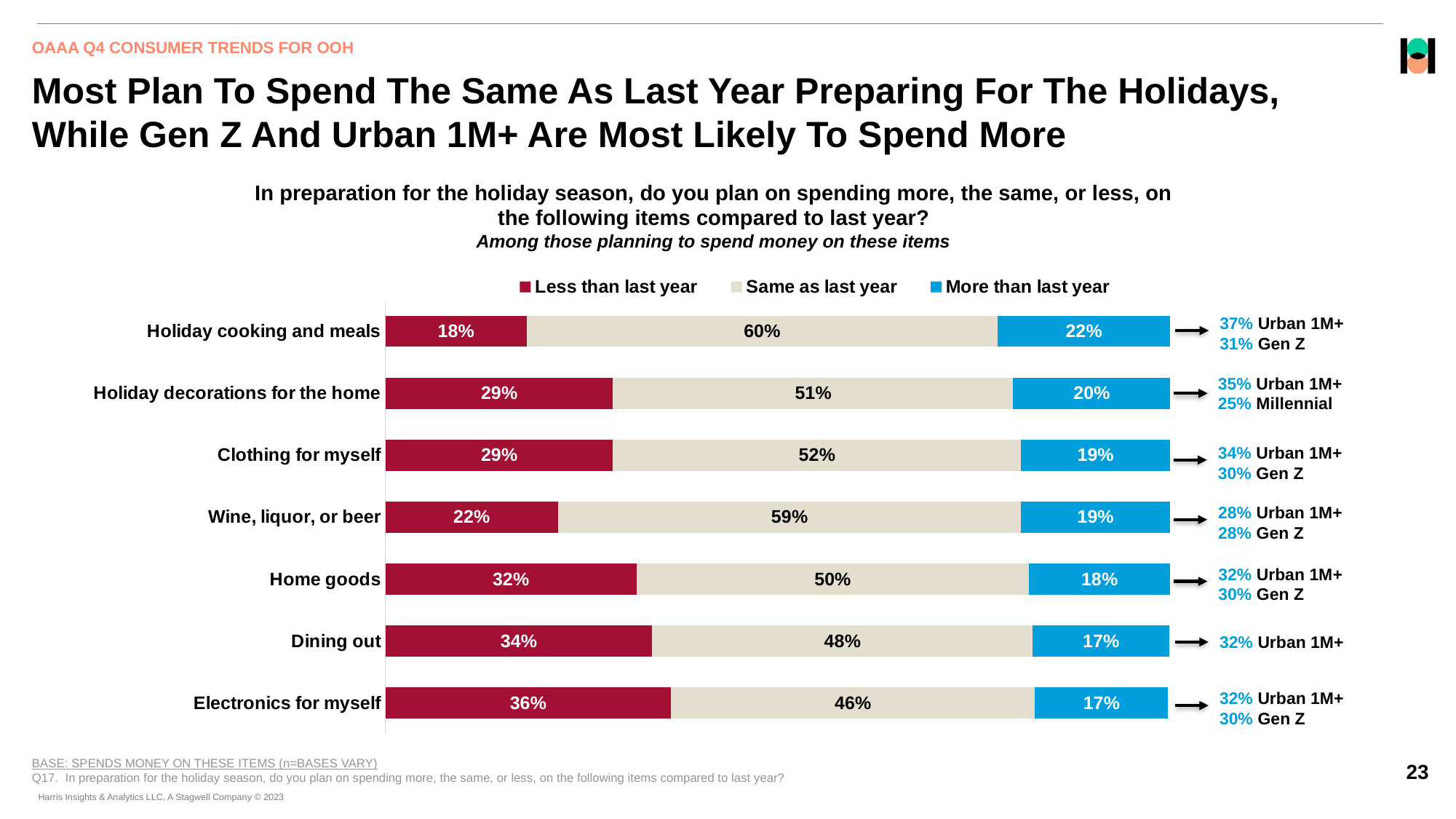
What percentage plan to spend the same as last year on Holiday cooking and meals? 60% What is the difference between the 'Same as last year' share for Holiday cooking and meals and for Electronics for myself? 14% How many items are listed in the chart? 7 What is the total of the three segments for the Wine, liquor, or beer bar? 100% Which is larger: the 'Less than last year' share for Dining out or for Home goods? Dining out What percentage plan to spend less than last year on Electronics for myself? 36% What percentage plan to spend more than last year on Holiday decorations for the home? 20% Which item has the highest share planning to spend more than last year? Holiday cooking and meals How many series does the legend list? 3 Which item has the highest share planning to spend less than last year? Electronics for myself What kind of chart is shown on the slide? Stacked bar chart Which item has the lowest share planning to spend less than last year? Holiday cooking and meals